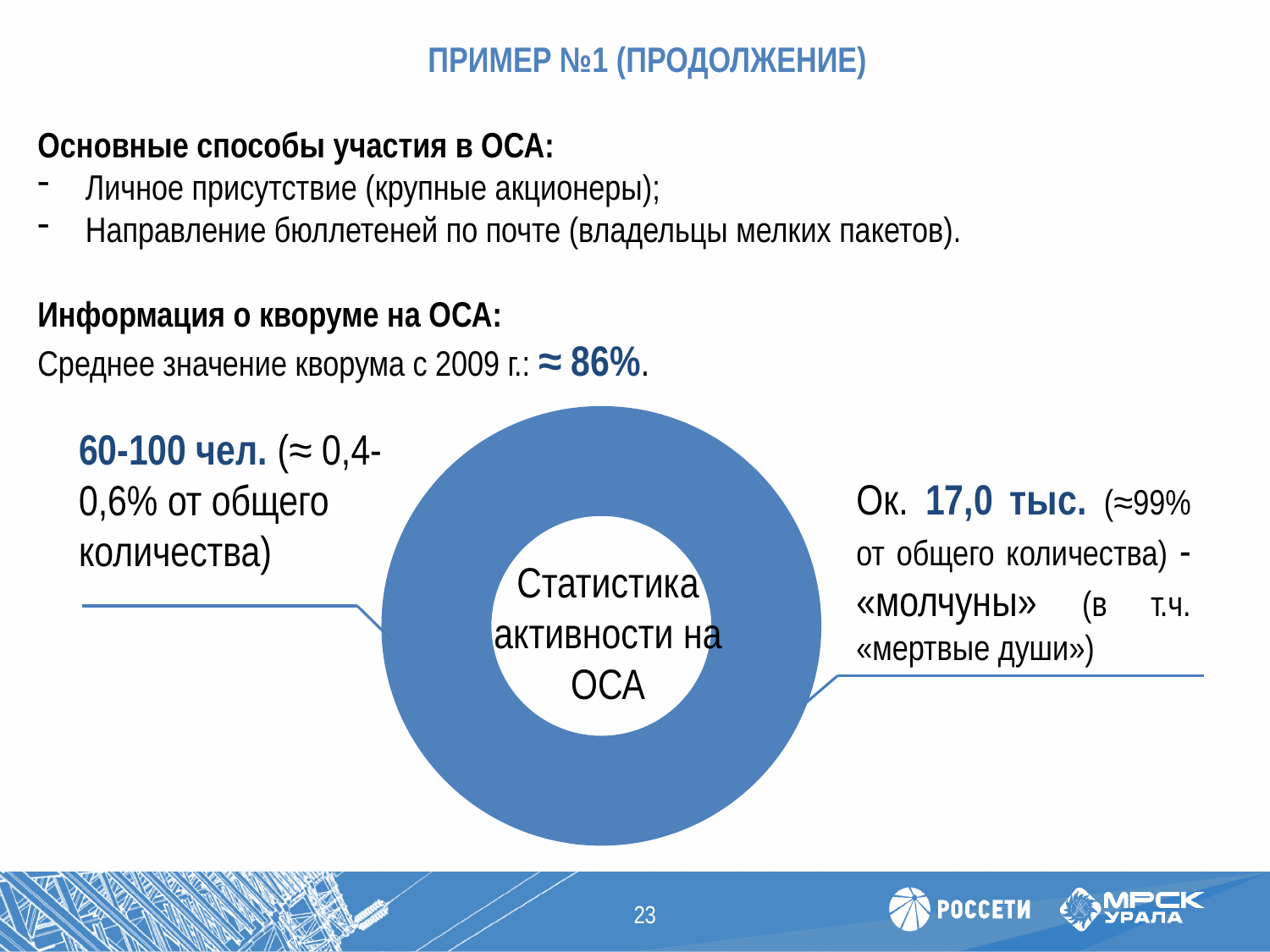
Which group is larger according to the chart callouts: the active participants (60-100 чел.) or the «молчуны»? «молчуны» Which group does the chart identify as the smallest share of shareholders? Active participants (60-100 чел.) What text is written in the centre of the donut chart? Статистика активности на ОСА How many callouts with values are attached to the donut chart? 2 What kind of chart is shown on the slide? Donut (pie) chart What colour is the ring of the donut chart? Blue How many people are given in the left callout of the chart as actively participating in the ОСА? 60-100 чел. Which group does the chart identify as the largest share of shareholders? «молчуны» How many shareholders are given in the right callout of the chart as «молчуны»? Ок. 17,0 тыс.